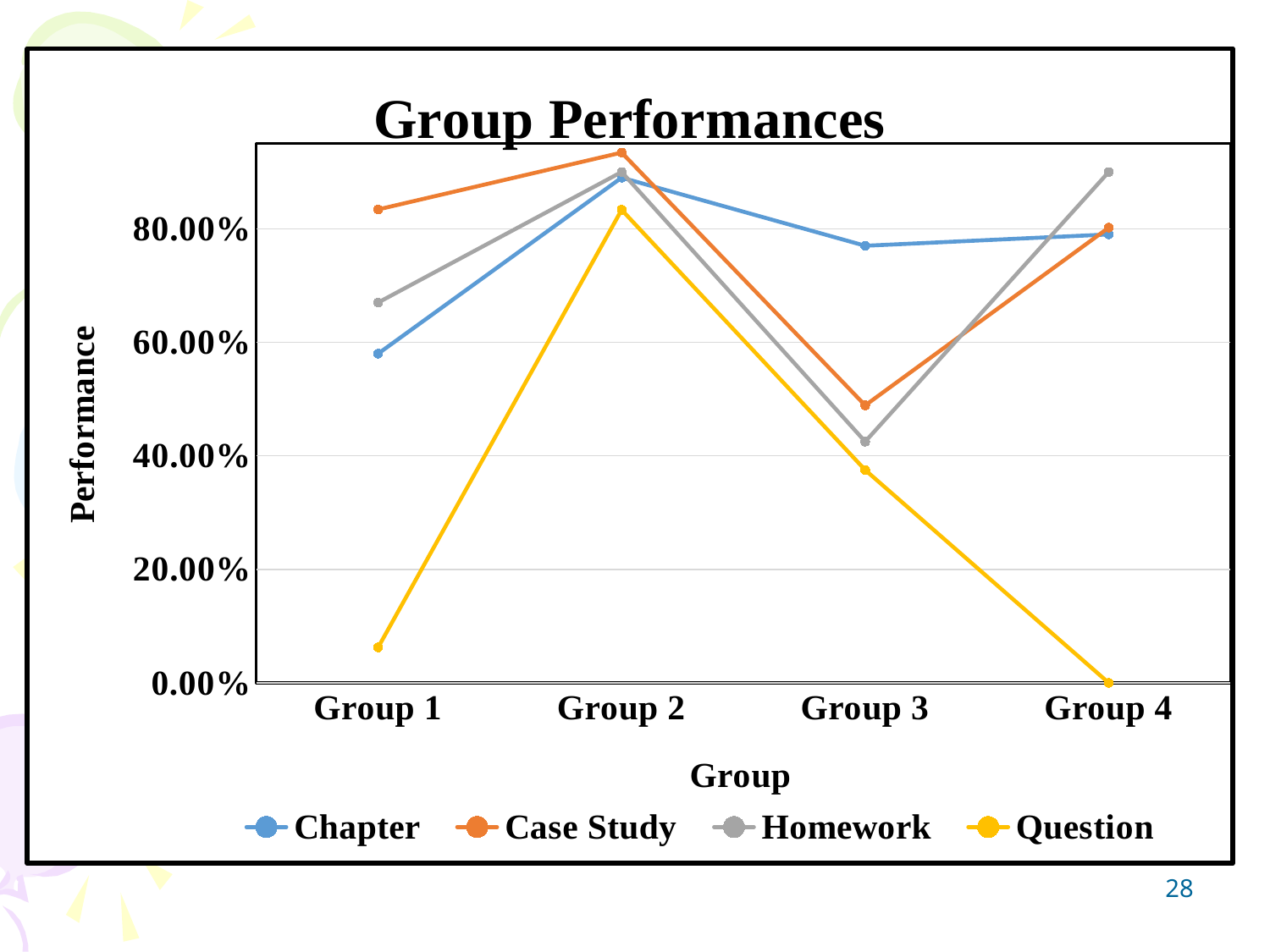
What is the Question series value for Group 4? 0.00% What kind of chart is shown on the slide? line chart Is the Case Study value for Group 2 greater or less than 80.00%? greater How many series does the legend list? 4 For which group is the Question series highest? Group 2 Is the Homework value for Group 3 greater or less than 60.00%? less For which group is the Case Study series lowest? Group 3 Does the Question series rise or fall from Group 2 to Group 4? fall How many groups are shown on the x axis? 4 What is the title of the chart? Group Performances Is the Question series value for Group 1 greater or less than 20.00%? less For Group 1, which is larger: Case Study or Chapter? Case Study